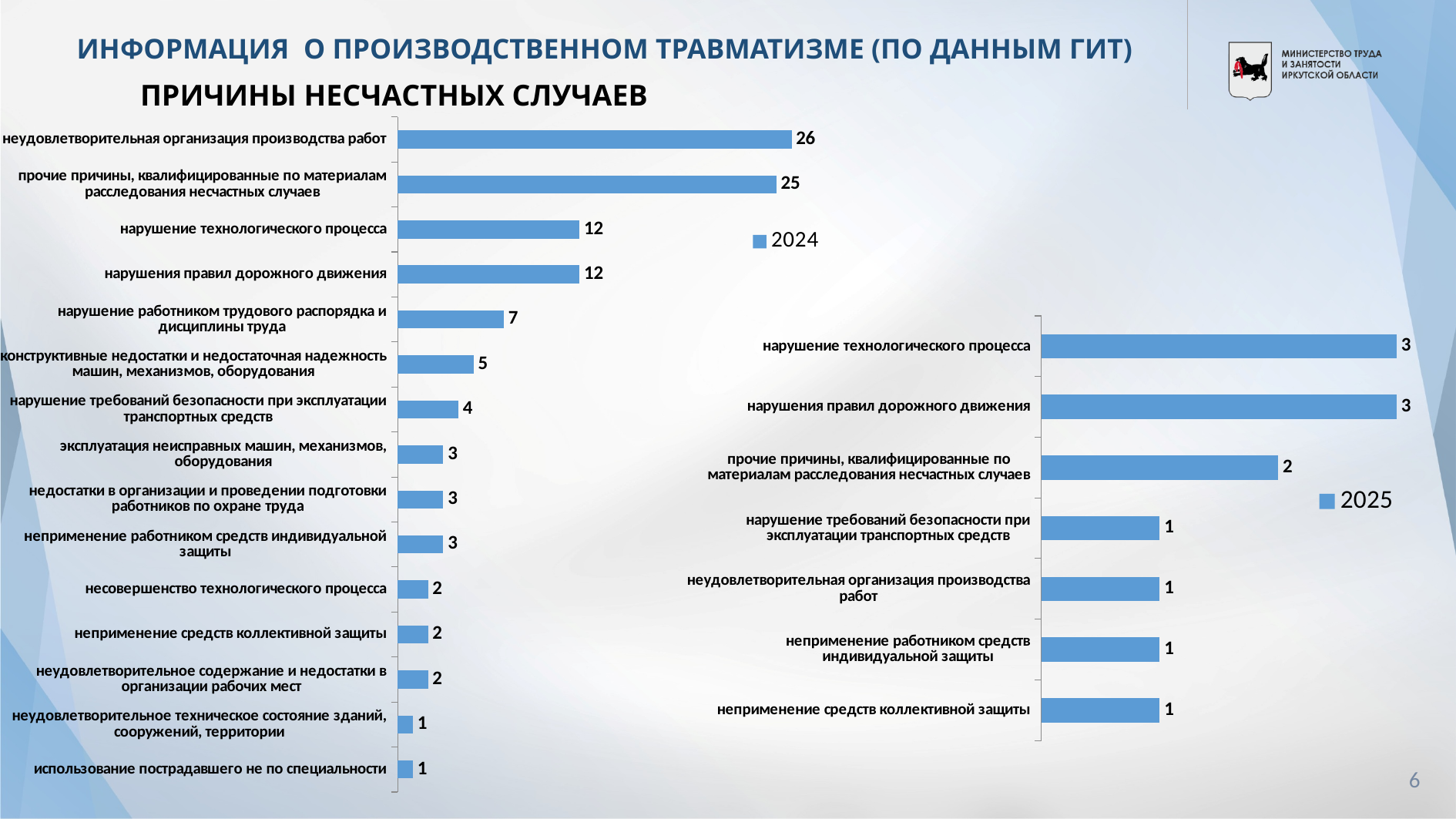
On the 2025 chart (right), which is larger: «нарушение технологического процесса» or «неприменение средств коллективной защиты»? нарушение технологического процесса On the 2024 chart (left), which category has the highest value? неудовлетворительная организация производства работ How many categories are shown on the 2025 chart (right)? 7 How many categories are shown on the 2024 chart (left)? 15 On the 2024 chart (left), what is the value for «неудовлетворительная организация производства работ»? 26 On the 2024 chart (left), which is larger: «нарушение требований безопасности при эксплуатации транспортных средств» or «несовершенство технологического процесса»? нарушение требований безопасности при эксплуатации транспортных средств What type of chart is the 2025 chart (right)? bar chart On the 2024 chart (left), what is the value for «нарушение работником трудового распорядка и дисциплины труда»? 7 On the 2025 chart (right), what is the value for «прочие причины, квалифицированные по материалам расследования несчастных случаев»? 2 On the 2024 chart (left), what is the difference between «неудовлетворительная организация производства работ» and «прочие причины, квалифицированные по материалам расследования несчастных случаев»? 1 What legend entry is shown for the left chart? 2024 On the 2024 chart (left), what is the difference between «нарушение технологического процесса» and «конструктивные недостатки и недостаточная надежность машин, механизмов, оборудования»? 7